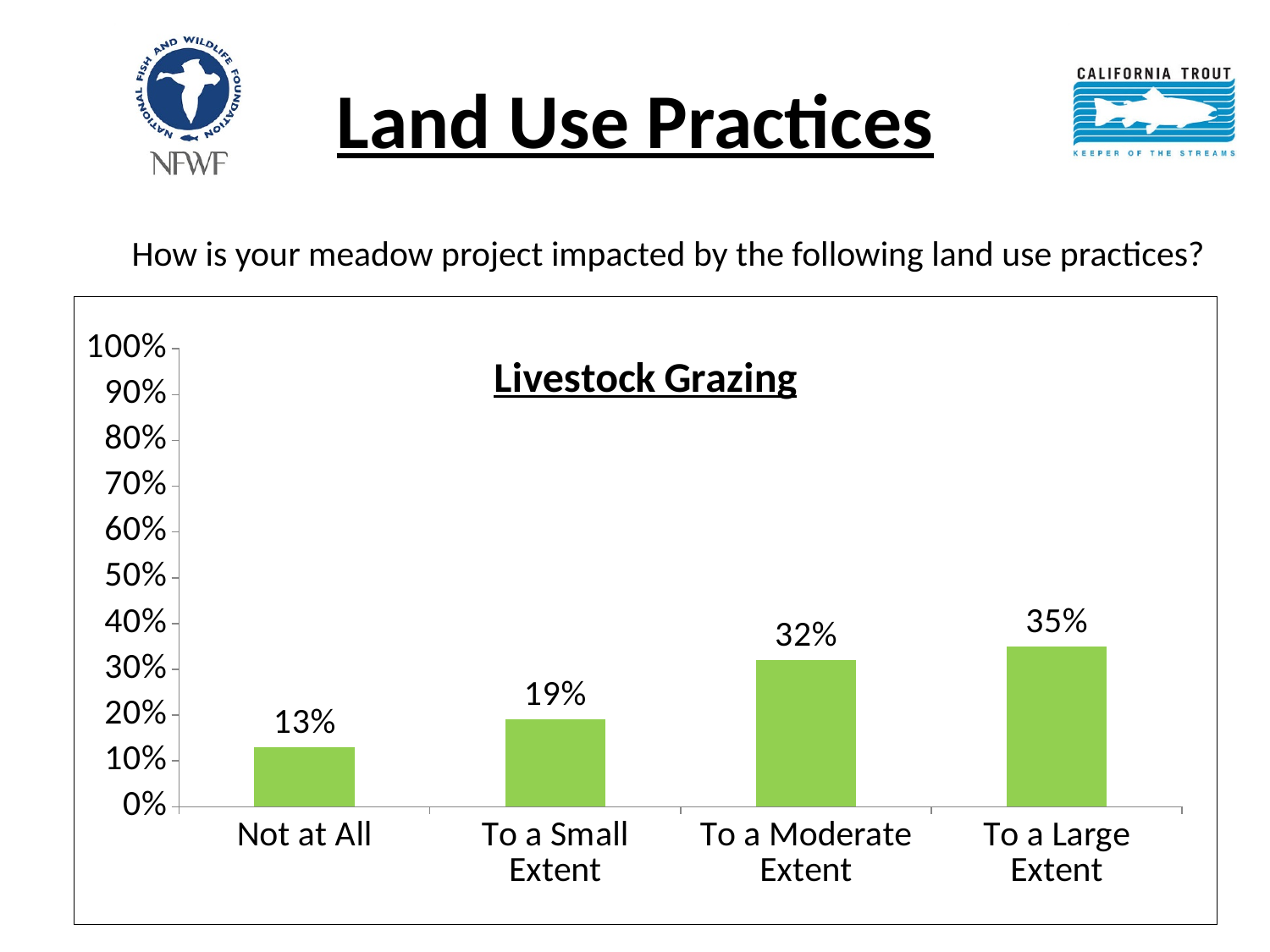
How many categories are shown on the x axis? 4 Which is larger, the value for "To a Small Extent" or "To a Moderate Extent"? To a Moderate Extent Do the values rise or fall from left to right along the x axis? rise What is the value for "To a Large Extent"? 35% What is the value for "To a Moderate Extent"? 32% What is the value for "Not at All"? 13% What is the value for "To a Small Extent"? 19% Is the value for "To a Moderate Extent" greater or less than 20%? greater Which category has the lowest value? Not at All What kind of chart is shown? bar chart Which category has the highest value? To a Large Extent What is the difference between the values for "To a Large Extent" and "Not at All"? 22%